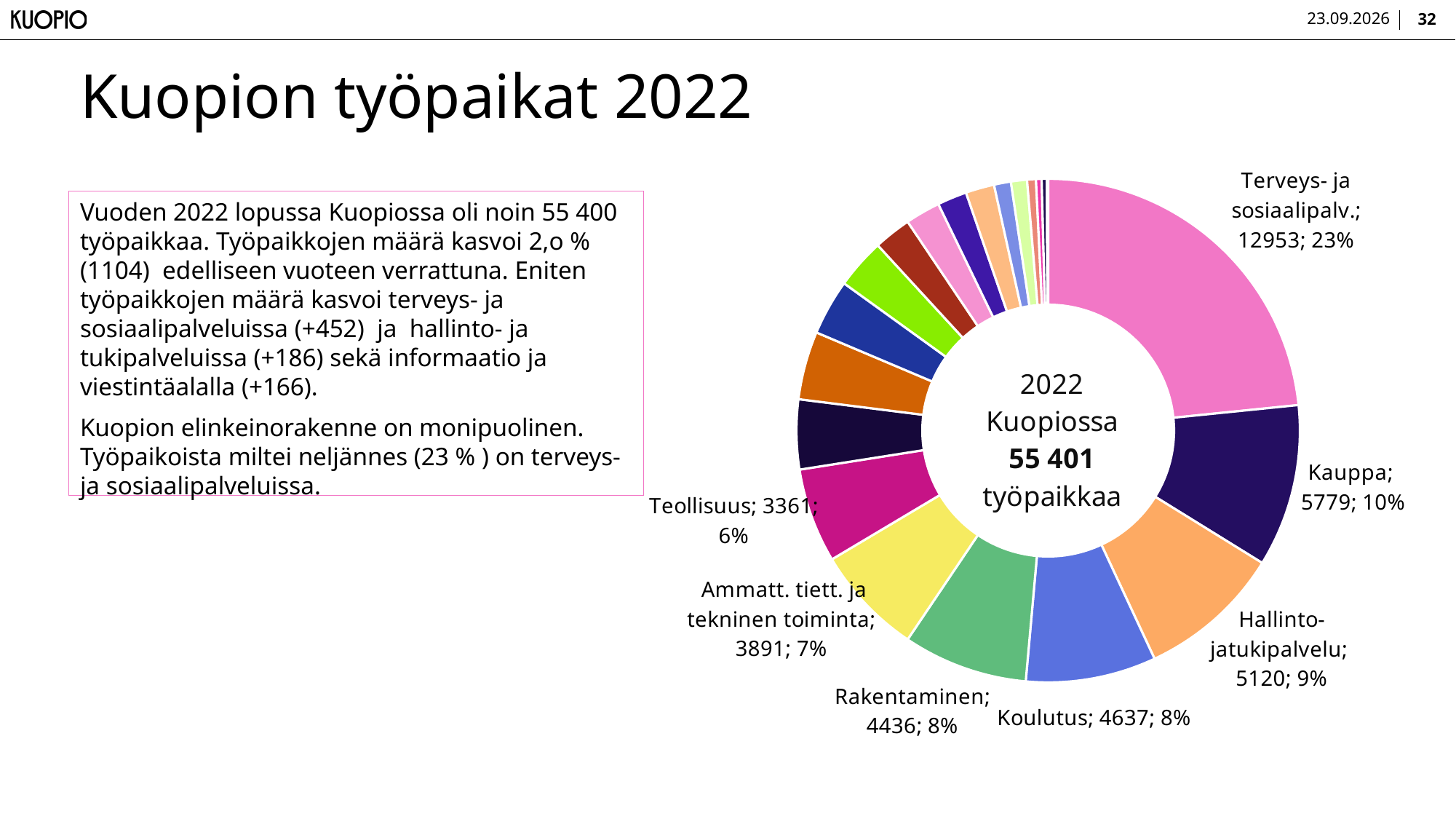
What total number of jobs is printed in the centre of the chart? 55 401 How much larger is the value for Terveys- ja sosiaalipalv. than the value for Kauppa? 7174 What share of the jobs does the Kauppa slice represent? 10% What percentage share is shown for Teollisuus? 6% Which labelled sector has the largest slice? Terveys- ja sosiaalipalv. What colour is the Terveys- ja sosiaalipalv. slice? pink What is the value shown for Ammatt. tiett. ja tekninen toiminta? 3891 How many jobs does the chart show for Terveys- ja sosiaalipalv.? 12953 Which has the larger value, Koulutus or Rakentaminen? Koulutus What is the difference between the values for Kauppa and Hallinto- ja tukipalvelu? 659 What is the value shown for Koulutus? 4637 What kind of chart is shown on the slide? doughnut chart